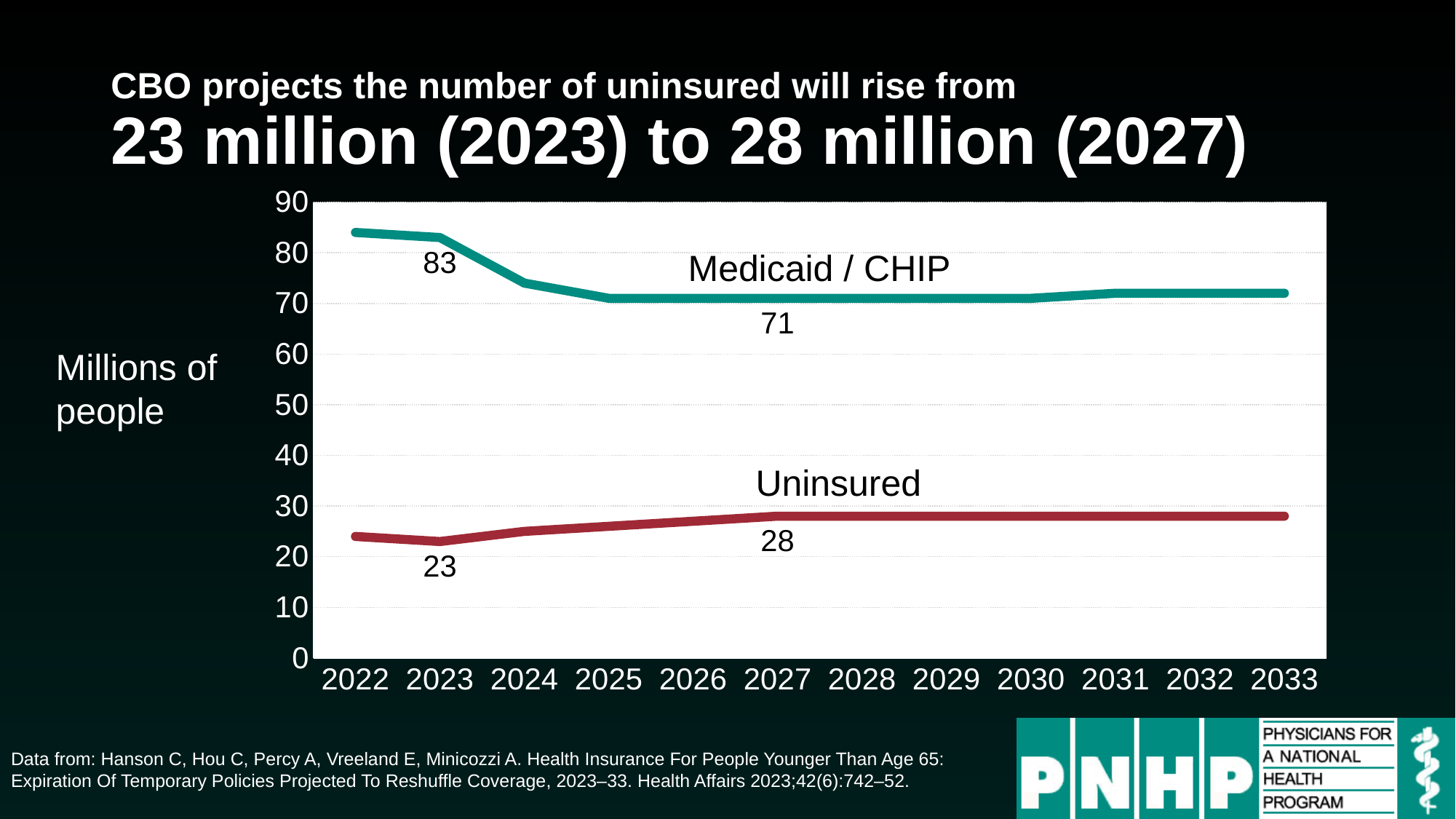
By how much does the Medicaid / CHIP value fall from 2023 to 2027? 12 Is the Uninsured value in 2033 greater or less than 30? less What is the Medicaid / CHIP value in 2023? 83 What is the Medicaid / CHIP value in 2027? 71 Is the Medicaid / CHIP value in 2022 greater or less than 80? greater Which series has the higher value in 2027, Medicaid / CHIP or Uninsured? Medicaid / CHIP How many years are shown on the x axis? 12 Does the Medicaid / CHIP line rise or fall between 2023 and 2025? fall What is the Uninsured value in 2027? 28 By how much does the Uninsured value change from 2023 to 2027? 5 What kind of chart is shown on the slide? line chart What is the Uninsured value in 2023? 23